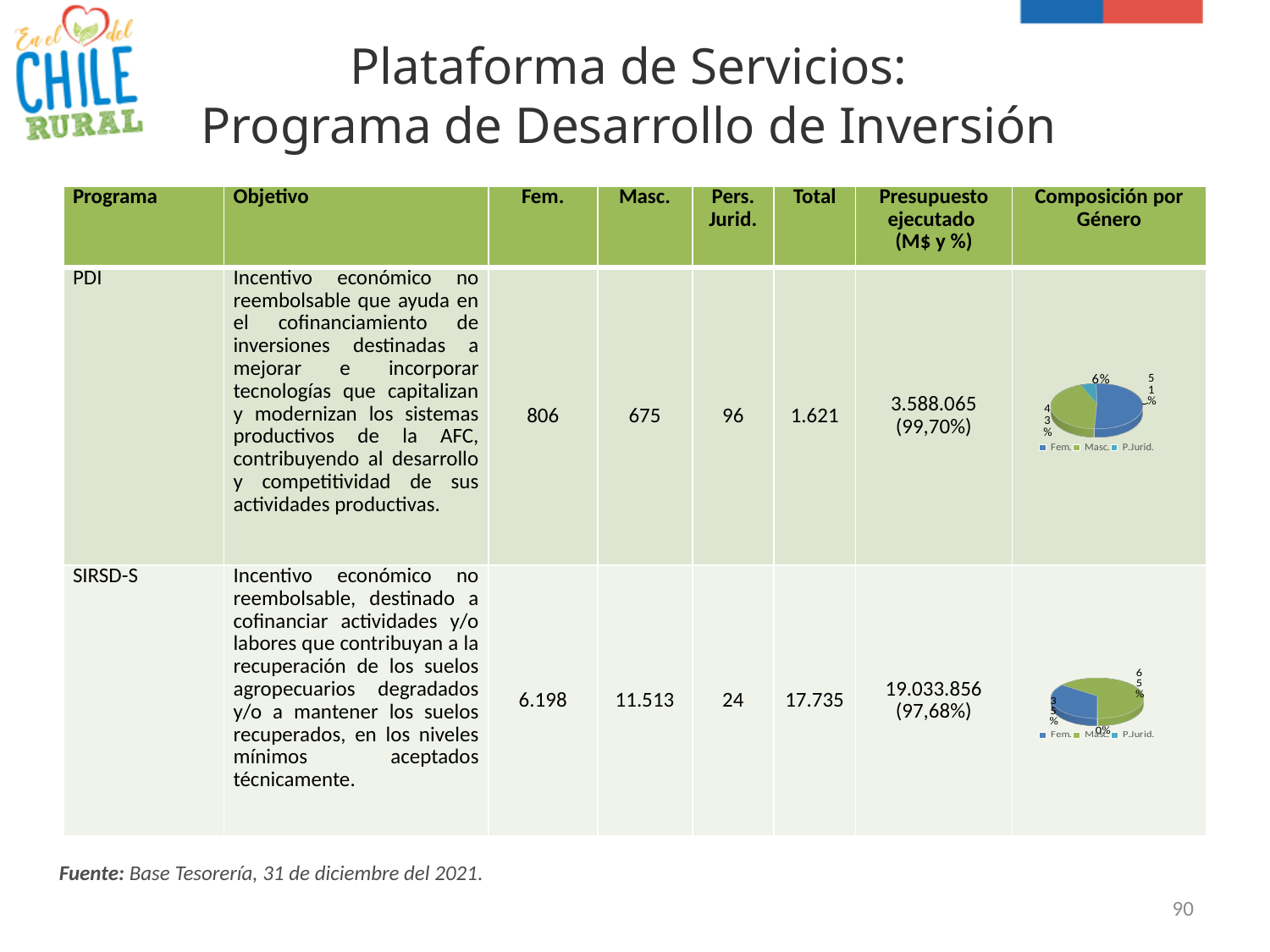
What type of chart is shown in the Composición por Género column for the PDI row? pie chart In the PDI pie chart, which category has the smallest slice? P.Jurid. In the SIRSD-S pie chart, which slice is larger, Fem. or Masc.? Masc. In the SIRSD-S pie chart, what share is labelled for Masc.? 65% In the SIRSD-S pie chart, which category has the largest slice? Masc. In the SIRSD-S pie chart, what share is labelled for P.Jurid.? 0% In the PDI pie chart, what share is labelled for P.Jurid.? 6% What are the legend entries of the SIRSD-S pie chart? Fem., Masc., P.Jurid. How many entries does the legend of the PDI pie chart list? 3